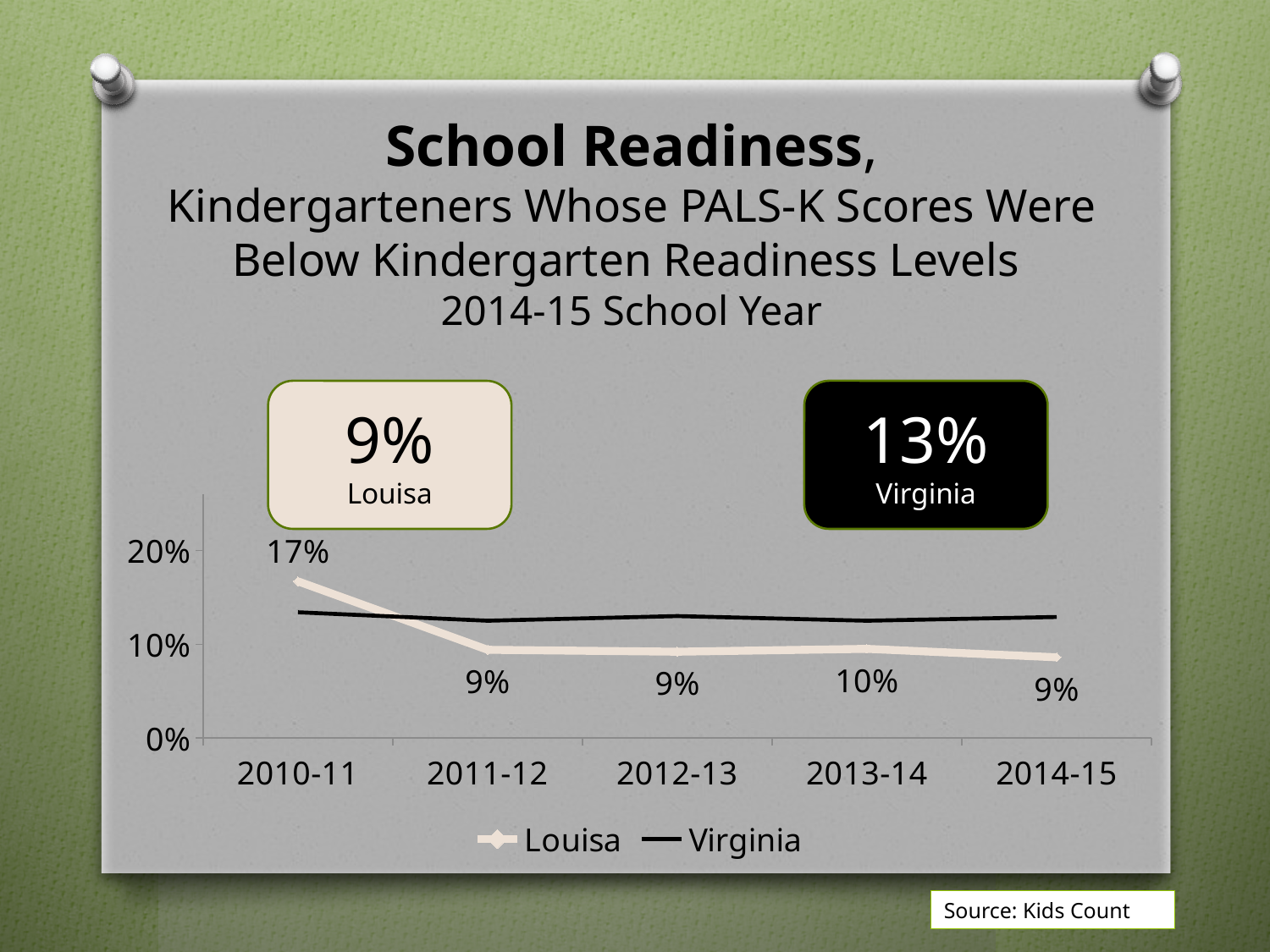
What source is cited for the chart data? Kids Count Is the Virginia value for 2012-13 greater or less than 10%? greater What kind of chart is shown on the slide? line chart How many school years are plotted on the x axis? 5 How many series does the chart's legend list? 2 By how many percentage points did the Louisa value drop from 2010-11 to 2011-12? 8 percentage points In 2014-15, which is higher, Louisa or Virginia? Virginia What was the Louisa value in 2013-14? 10% Does the Louisa line rise or fall overall from 2010-11 to 2014-15? fall In which school year was the Louisa value highest? 2010-11 What was the Virginia value in the 2014-15 school year? 13% What was the Louisa value in 2010-11? 17%